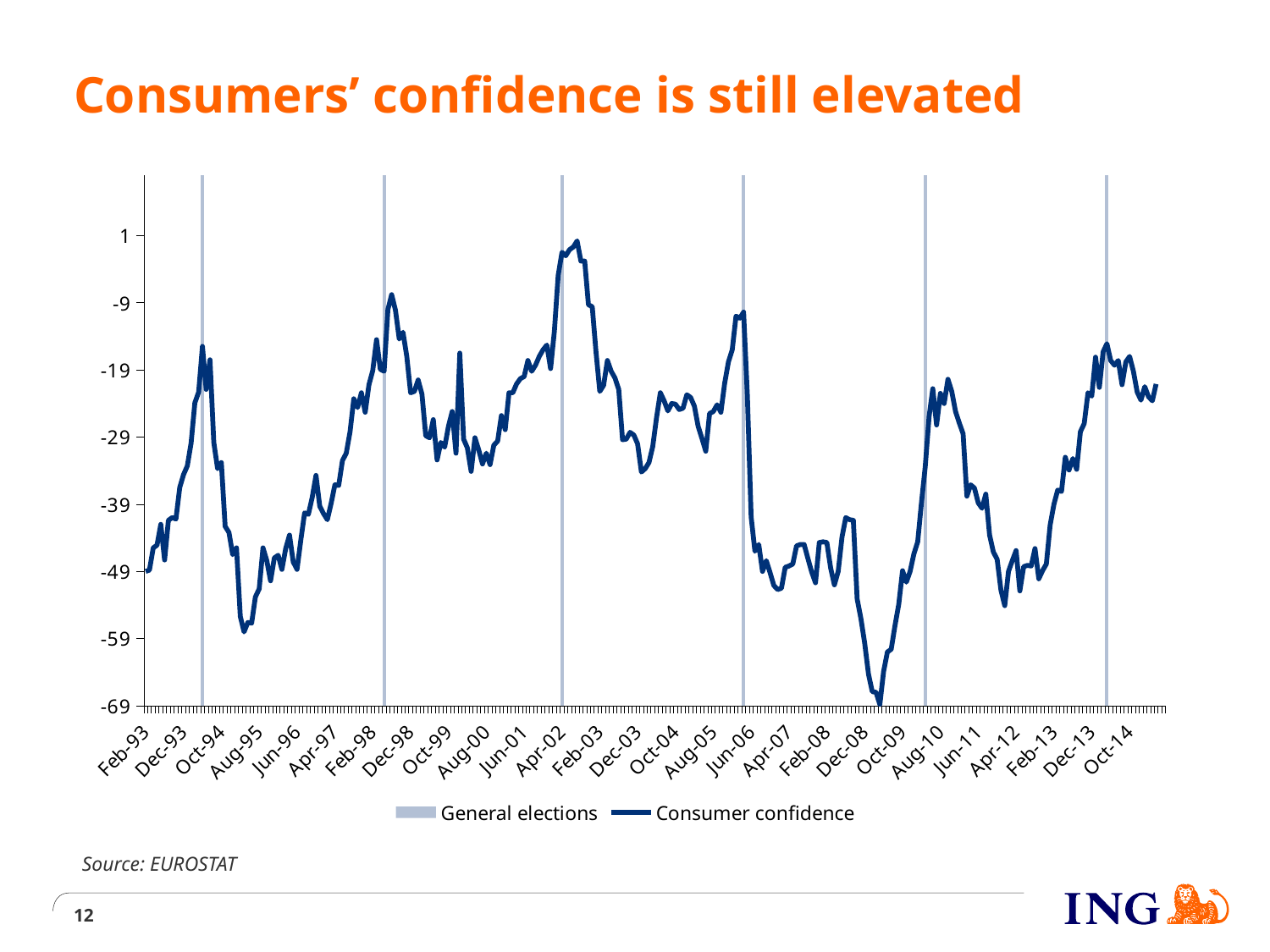
What is the title of the slide's chart? Consumers' confidence is still elevated Is the consumer confidence value at Aug-95 greater or less than -49? less Does consumer confidence rise or fall between Oct-09 and Aug-10? rise What is the source given for the chart data? EUROSTAT How many series does the legend list? 2 Is the consumer confidence value at Oct-14 greater or less than -29? greater Is the consumer confidence value at Feb-02 greater or less than -9? less What kind of chart is shown on the slide? combination bar and line chart How many general election bars are marked on the chart? 6 Does consumer confidence rise or fall between Jun-06 and Apr-07? fall Which is larger, the consumer confidence value at Feb-02 or at Dec-08? Feb-02